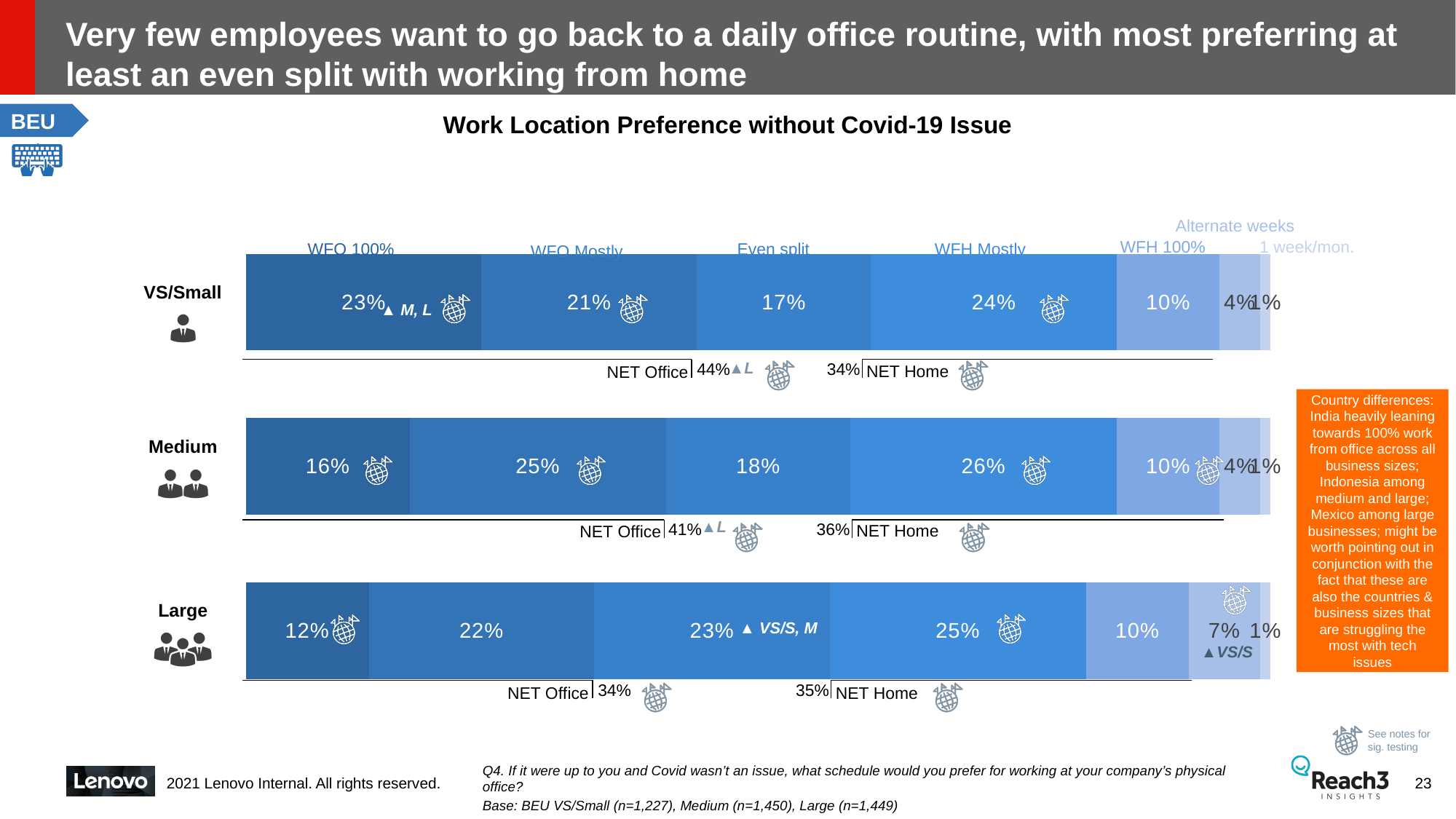
Which business size has the highest WFO Mostly value? Medium What is the Alternate weeks value for Large businesses? 7% What is the Even split value for Large businesses? 23% Is the NET Office value larger for VS/Small or for Large businesses? VS/Small What kind of chart is shown on the slide? Stacked bar chart Which business size has the lowest WFO 100% value? Large How many business-size categories are plotted in the chart? 3 What is the WFO 100% value for VS/Small businesses? 23% What is the title of the chart? Work Location Preference without Covid-19 Issue What is the difference between the WFO 100% values for VS/Small and Large businesses? 11 percentage points What is the WFH Mostly value for Medium businesses? 26% What is the NET Home value for Medium businesses? 36%